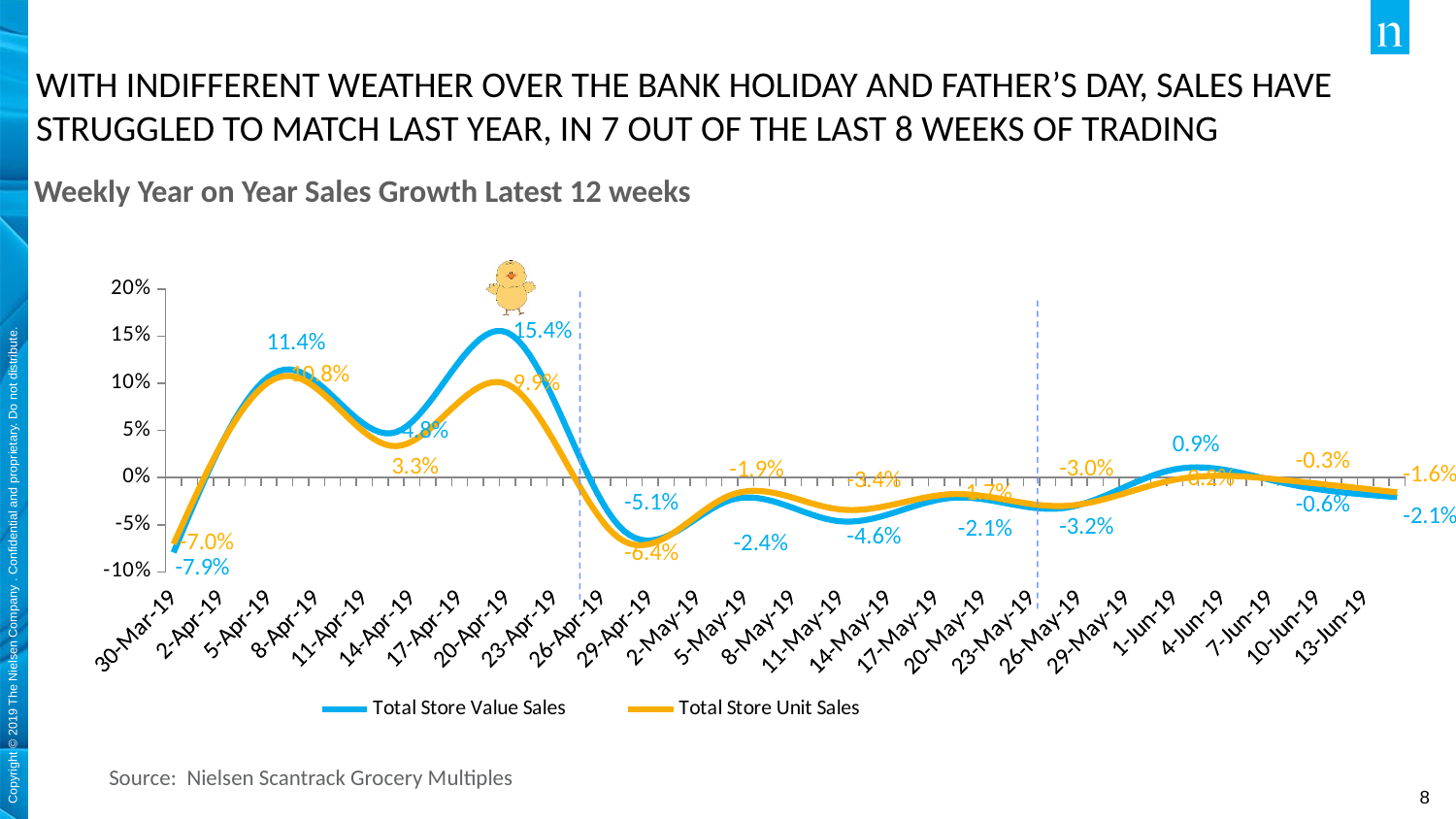
What kind of chart is shown on the slide? line chart What is the highest labelled value for Total Store Value Sales? 15.4% At the first data point (30-Mar-19), which series has the lower value, Total Store Value Sales or Total Store Unit Sales? Total Store Value Sales What is the highest labelled value for Total Store Unit Sales? 10.8% What is the last labelled value for Total Store Value Sales at the right end of the chart? -2.1% What is the lowest labelled value for Total Store Value Sales? -7.9% How many series does the legend list? 2 What is the lowest labelled value for Total Store Unit Sales? -7.0% At the peak where Total Store Value Sales is 15.4%, what is the difference between Total Store Value Sales and Total Store Unit Sales (9.9%)? 5.5 percentage points How many weeks does the chart cover according to its title? 12 Is the highest value of Total Store Value Sales greater or less than 10%? greater What colour is the Total Store Unit Sales line? orange